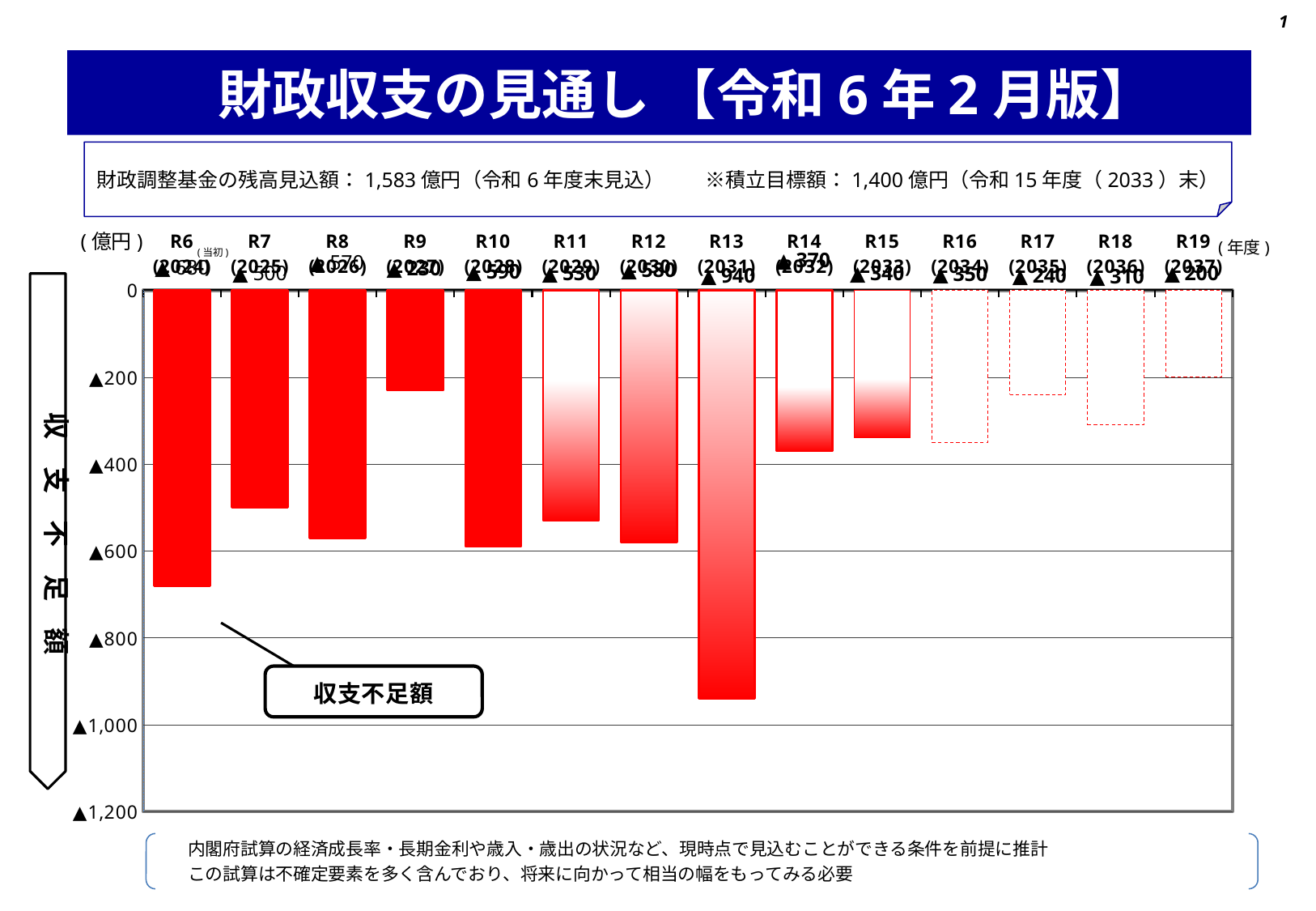
Which fiscal year has the largest deficit (longest bar)? R13 (2031) Is the deficit for R6 (2024) greater or less than 600 億円? greater What is the value shown for R19 (2037)? ▲200 What is the value shown for R10 (2028)? ▲590 How many fiscal years are plotted on the chart? 14 What kind of chart is shown on the slide? bar chart What is the difference between the values for R13 (2031) and R10 (2028)? 350 What is the value shown for R17 (2035)? ▲240 Which has the larger deficit, R12 (2030) or R11 (2029)? R12 (2030) What unit is shown for the vertical axis of the chart? 億円 What is the value shown for R13 (2031)? ▲940 What is the value shown for R7 (2025)? ▲500